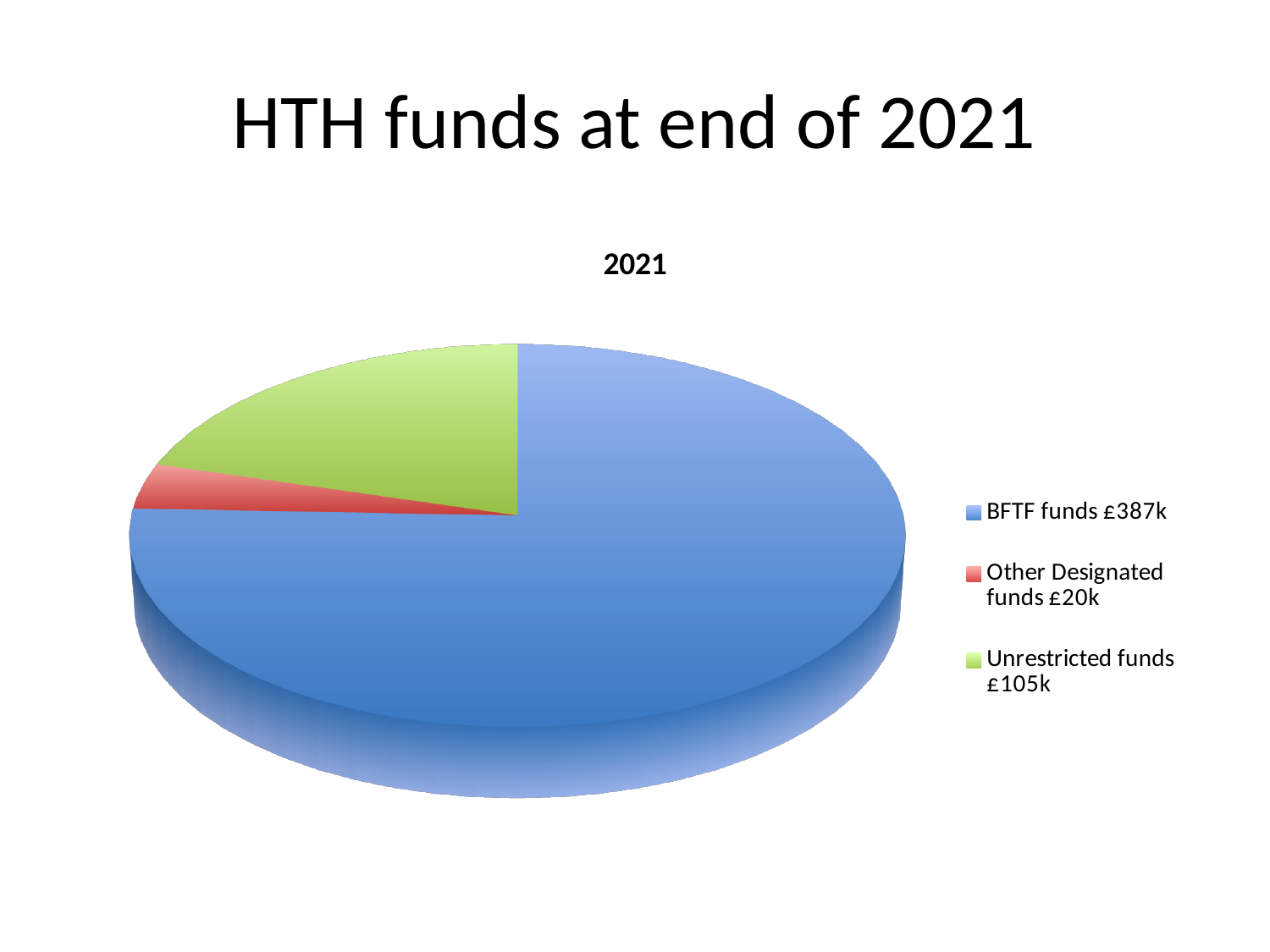
Which colour represents Unrestricted funds in the pie chart? green What is the total of all three fund categories? £512k What is the difference between BFTF funds and Unrestricted funds? £282k Which fund category is the smallest? Other Designated funds What type of chart is shown on the slide? pie chart What is the value of Other Designated funds? £20k What is the title of the chart? 2021 Which is larger, Unrestricted funds or Other Designated funds? Unrestricted funds What is the value of BFTF funds? £387k Which fund category is the largest? BFTF funds How many slices does the pie chart have? 3 What is the value of Unrestricted funds? £105k